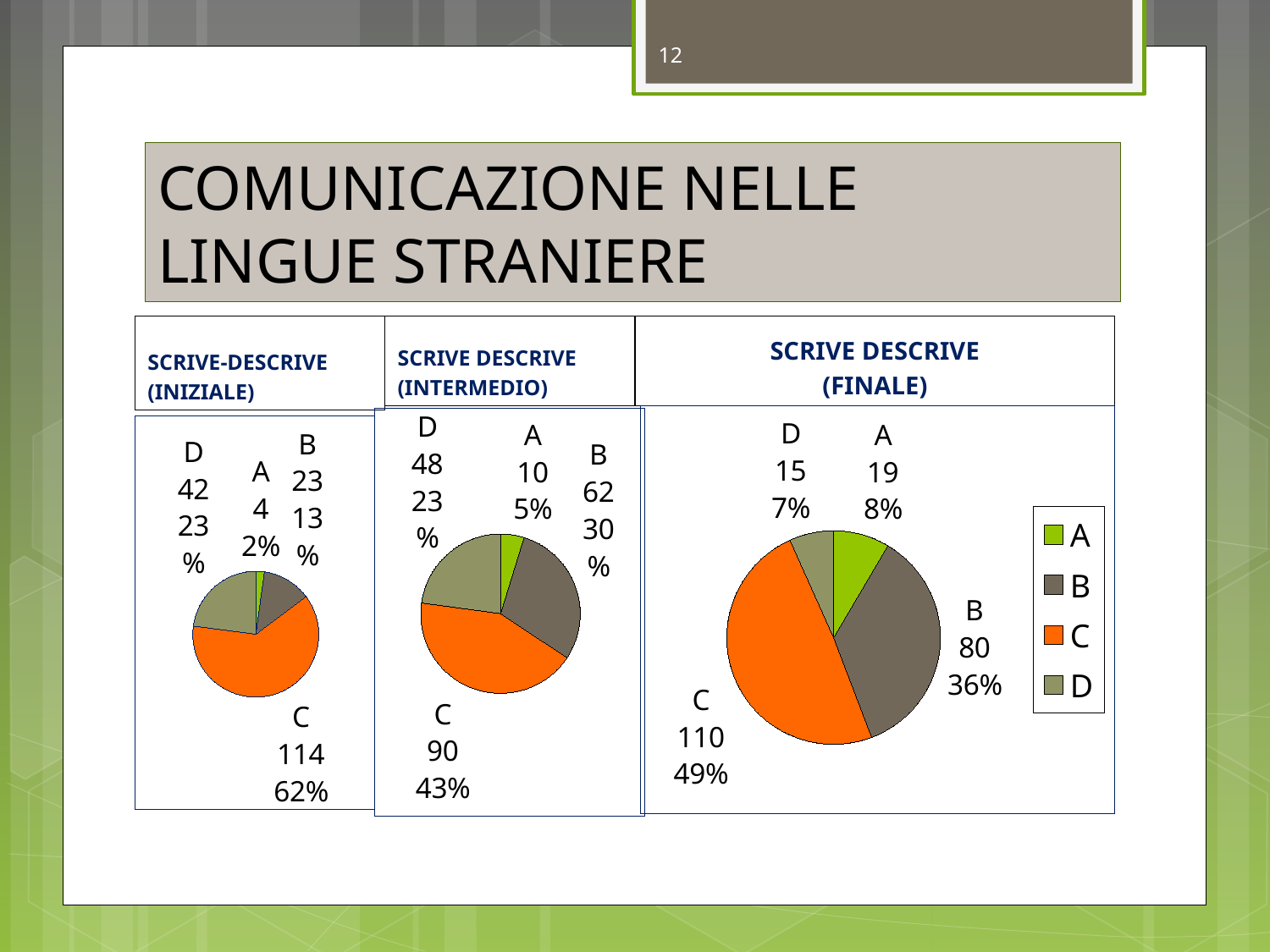
In the SCRIVE-DESCRIVE (INIZIALE) pie chart, what is the value for C? 114 In the SCRIVE DESCRIVE (FINALE) pie chart, which category has the largest slice? C In the SCRIVE DESCRIVE (INTERMEDIO) pie chart, what is the value for B? 62 In the SCRIVE DESCRIVE (FINALE) pie chart, what is the value for A? 19 In the SCRIVE DESCRIVE (INTERMEDIO) pie chart, what share of the pie does C represent? 43% In the SCRIVE DESCRIVE (FINALE) pie chart, which category has the smallest slice? D In the SCRIVE-DESCRIVE (INIZIALE) pie chart, what share of the pie does D represent? 23% In the SCRIVE DESCRIVE (INTERMEDIO) pie chart, which is larger, the value for B or the value for D? B How many categories does the legend on the slide list? 4 In the SCRIVE-DESCRIVE (INIZIALE) pie chart, which category has the smallest slice? A What type of chart is used for SCRIVE DESCRIVE (FINALE)? Pie chart In the SCRIVE DESCRIVE (FINALE) pie chart, what is the difference between the values for C and B? 30